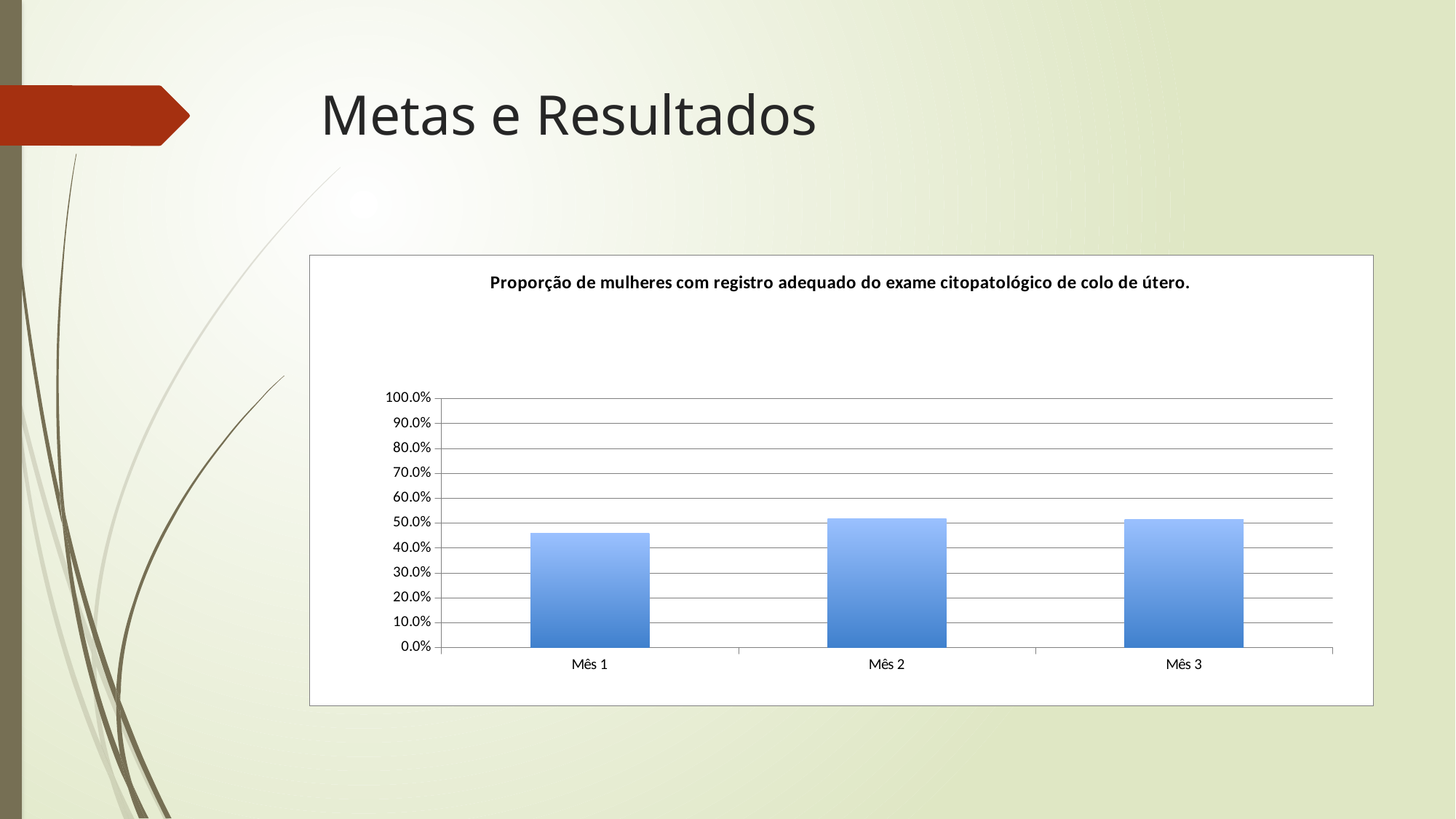
What is the title of the chart? Proporção de mulheres com registro adequado do exame citopatológico de colo de útero. Which is larger, the value for Mês 1 or the value for Mês 2? Mês 2 How many categories (months) are plotted in the chart? 3 What is the highest value shown on the vertical axis of the chart? 100.0% Is the value for Mês 3 greater or less than 50.0%? greater Is the value for Mês 1 greater or less than 40.0%? greater Is the value for Mês 1 greater or less than 50.0%? less Which is larger, the value for Mês 1 or the value for Mês 3? Mês 3 Which month has the lowest value in the chart? Mês 1 What kind of chart is shown on the slide? bar chart